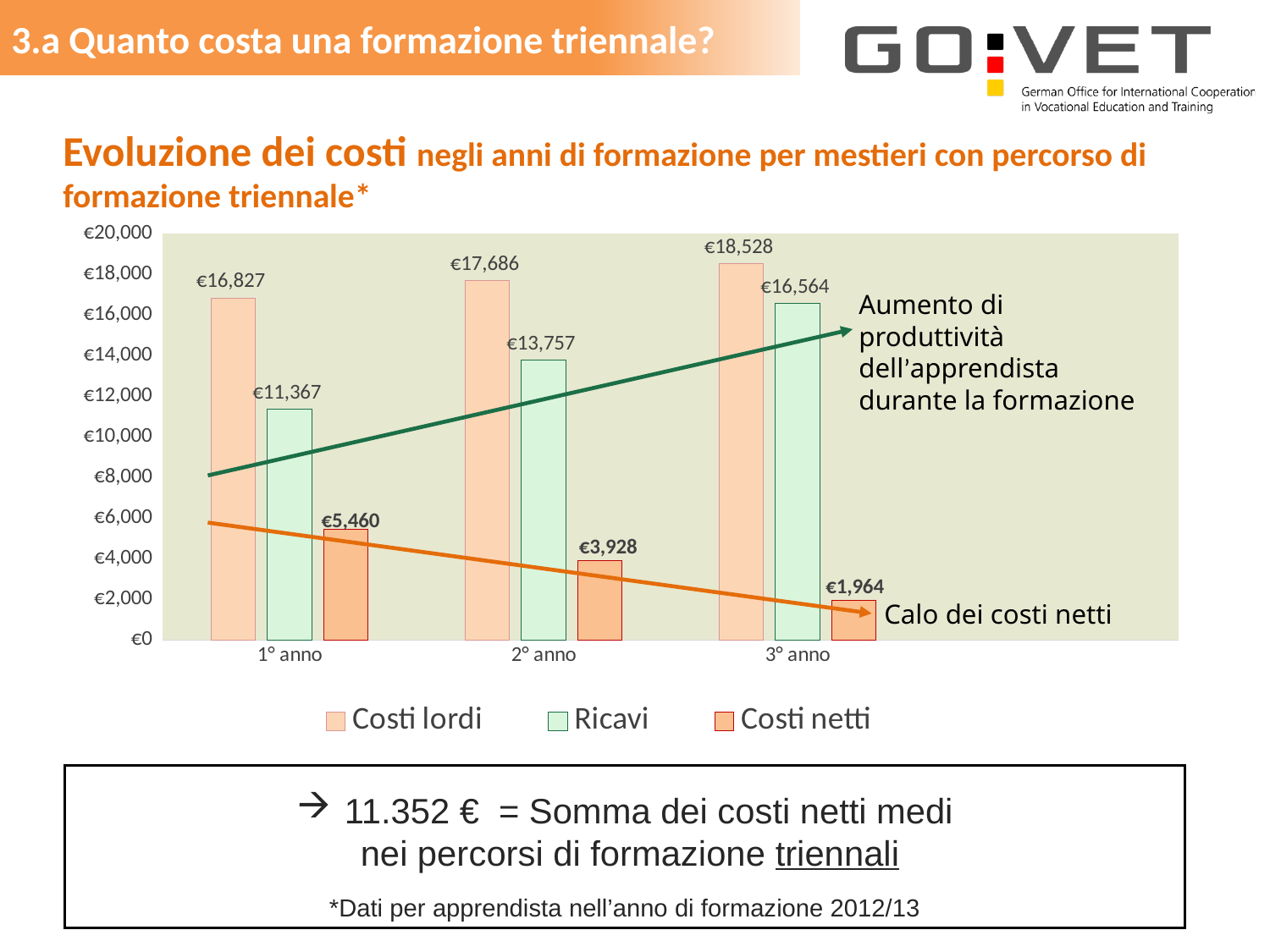
In which year is Costi netti lowest? 3° anno What is the value of Ricavi for 3° anno? €16,564 In which year is Costi lordi highest? 3° anno What kind of chart is shown on the slide? Bar chart What is the value of Ricavi for 2° anno? €13,757 What is the value of Costi netti for 3° anno? €1,964 Which is larger for 1° anno, Costi lordi or Ricavi? Costi lordi What is the value of Costi lordi for 1° anno? €16,827 What is the difference between Costi lordi and Ricavi for 2° anno? €3,929 Do the Costi netti values rise or fall from 1° anno to 3° anno? Fall How many series does the legend list? 3 How many years (categories) are shown on the x axis? 3